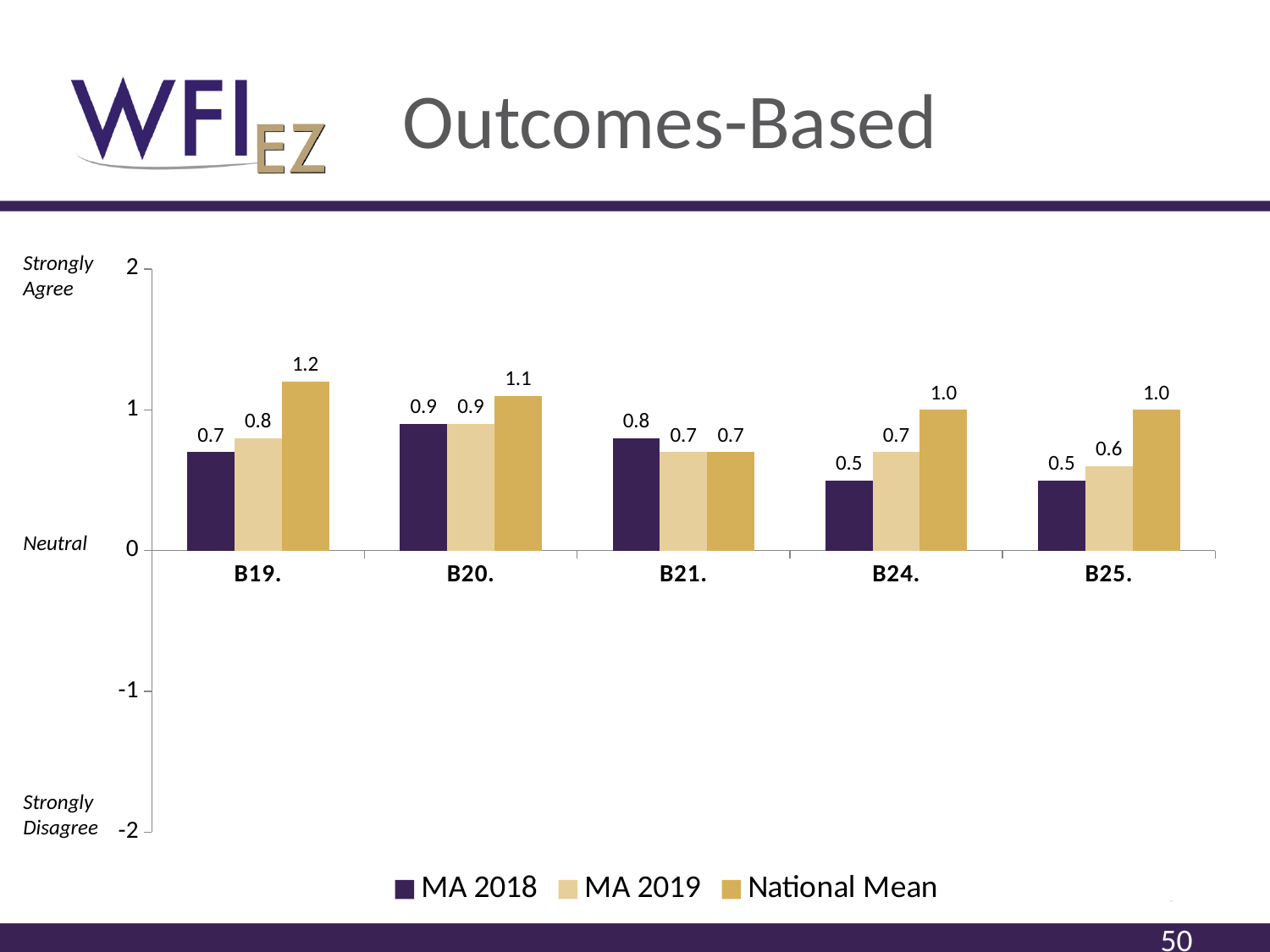
Which category has the highest National Mean value? B19. For B24., which is larger: the MA 2019 value or the National Mean value? National Mean What label is shown next to the 0 tick on the y axis? Neutral What is the MA 2019 value for B25.? 0.6 Is the National Mean value for B20. greater or less than 1? greater What kind of chart is shown on the slide? bar chart What is the National Mean value for B19.? 1.2 How many series does the legend list? 3 Which category has the lowest MA 2019 value? B25. What is the difference between the National Mean and MA 2018 values for B19.? 0.5 How many categories are shown on the x axis? 5 What is the MA 2018 value for B21.? 0.8